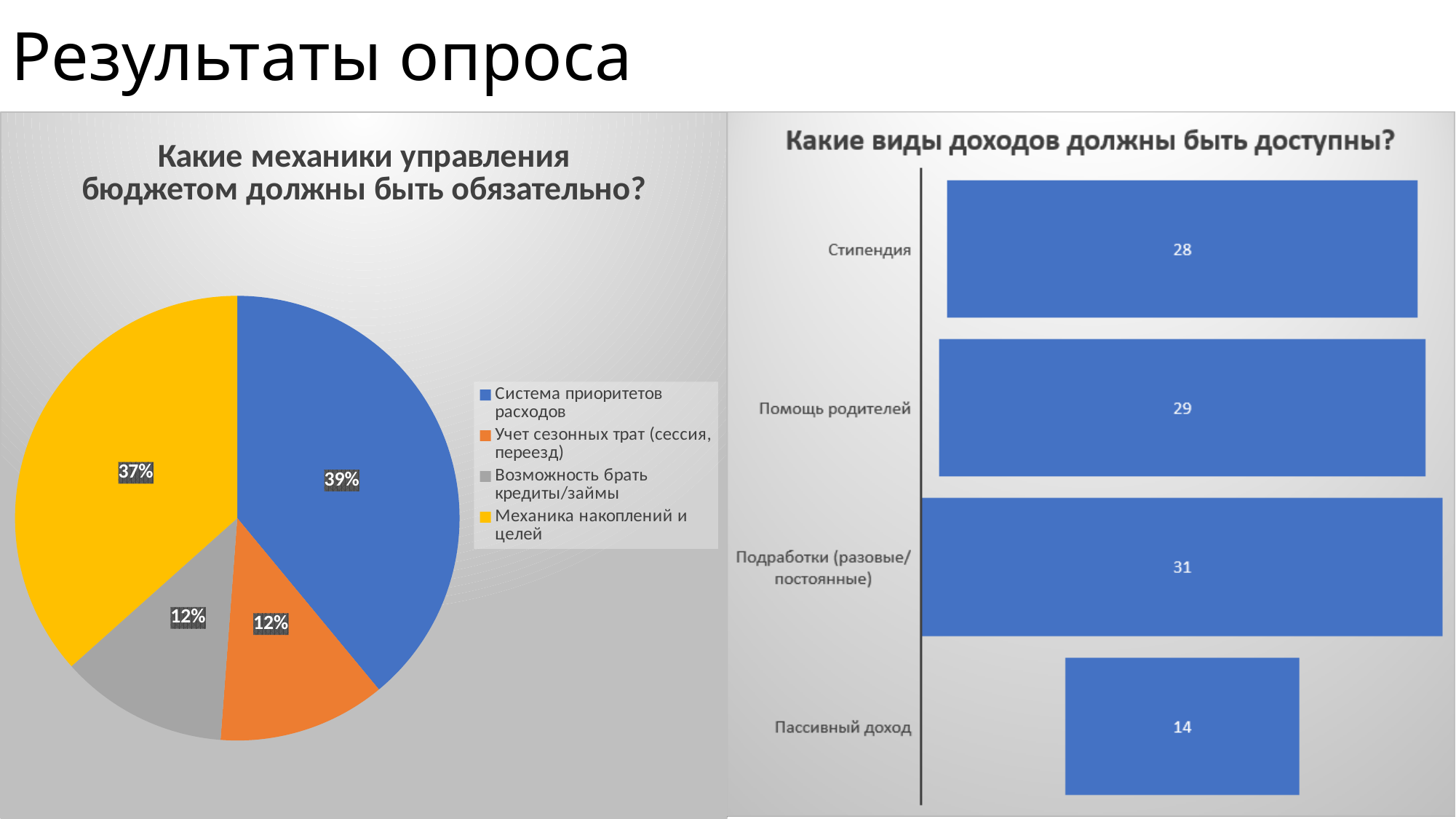
In the pie chart "Какие механики управления бюджетом должны быть обязательно?", what share does "Механика накоплений и целей" have? 37% In the chart "Какие виды доходов должны быть доступны?", what is the difference between "Подработки (разовые/постоянные)" and "Помощь родителей"? 2 In the pie chart "Какие механики управления бюджетом должны быть обязательно?", what is the difference between the shares of "Система приоритетов расходов" and "Механика накоплений и целей"? 2% In the chart "Какие виды доходов должны быть доступны?", which category has the highest value? Подработки (разовые/постоянные) In the pie chart "Какие механики управления бюджетом должны быть обязательно?", how many categories does the legend list? 4 In the pie chart "Какие механики управления бюджетом должны быть обязательно?", what share does "Система приоритетов расходов" have? 39% In the pie chart "Какие механики управления бюджетом должны быть обязательно?", what colour is the slice for "Учет сезонных трат (сессия, переезд)"? Orange In the chart "Какие виды доходов должны быть доступны?", which category has the lowest value? Пассивный доход In the chart "Какие виды доходов должны быть доступны?", what is the value for "Пассивный доход"? 14 In the chart "Какие виды доходов должны быть доступны?", what is the value for "Стипендия"? 28 What kind of chart is "Какие виды доходов должны быть доступны?"? Bar chart In the pie chart "Какие механики управления бюджетом должны быть обязательно?", which category has the largest share? Система приоритетов расходов